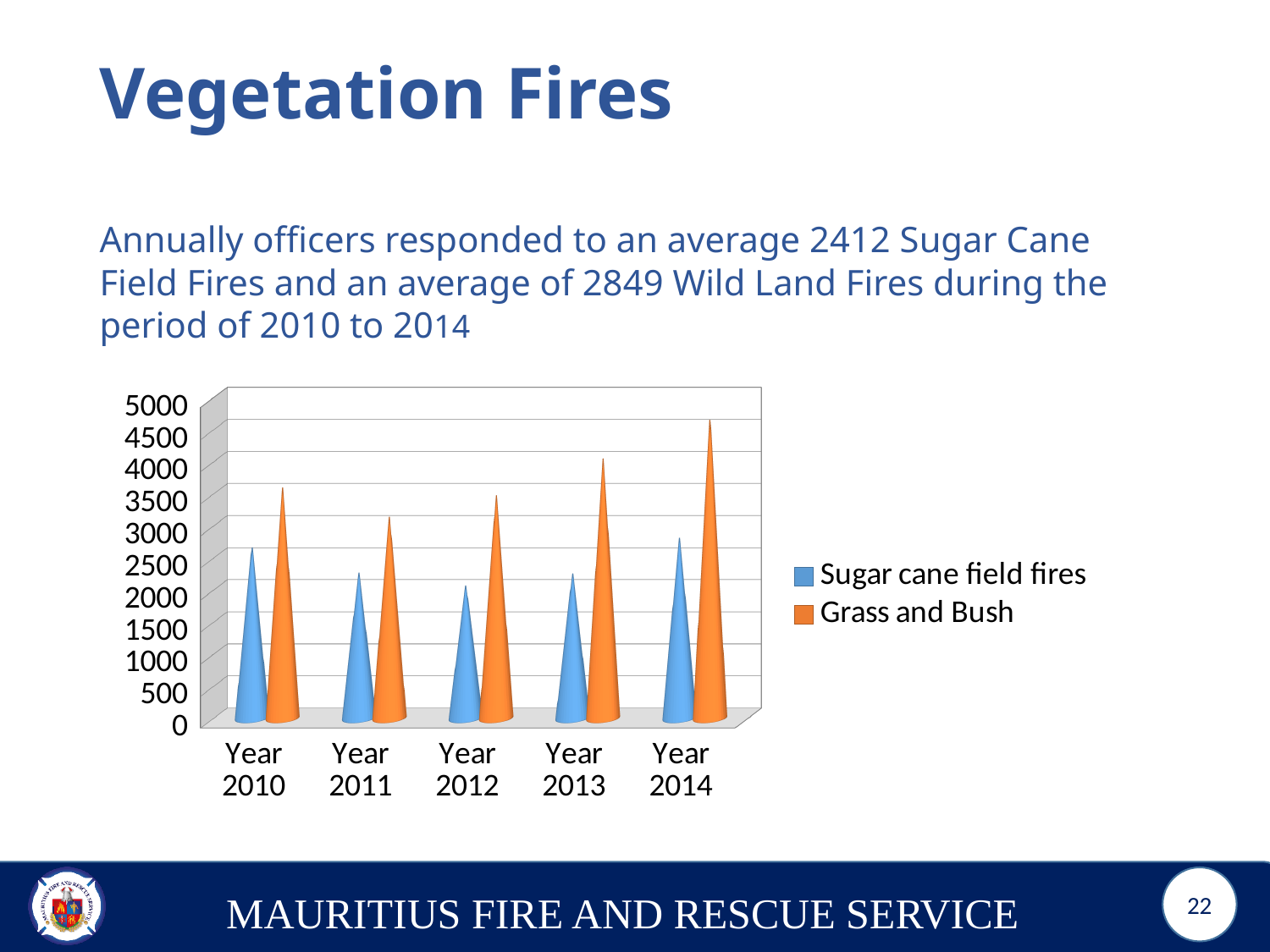
Is the Sugar cane field fires value for Year 2012 greater or less than 2500? less How many series does the chart's legend list? 2 How many years are shown on the x axis of the chart? 5 Which colour represents Grass and Bush in the chart? Orange In Year 2014, which is larger: Sugar cane field fires or Grass and Bush? Grass and Bush From Year 2012 to Year 2014, do the Grass and Bush values rise or fall? rise What kind of chart is shown on the slide? Bar chart In which year is the Grass and Bush value highest? Year 2014 What are the two series named in the chart's legend? Sugar cane field fires; Grass and Bush In which year is the Grass and Bush value lowest? Year 2011 Is the Grass and Bush value for Year 2014 greater or less than 4500? greater In which year is the Sugar cane field fires value highest? Year 2014